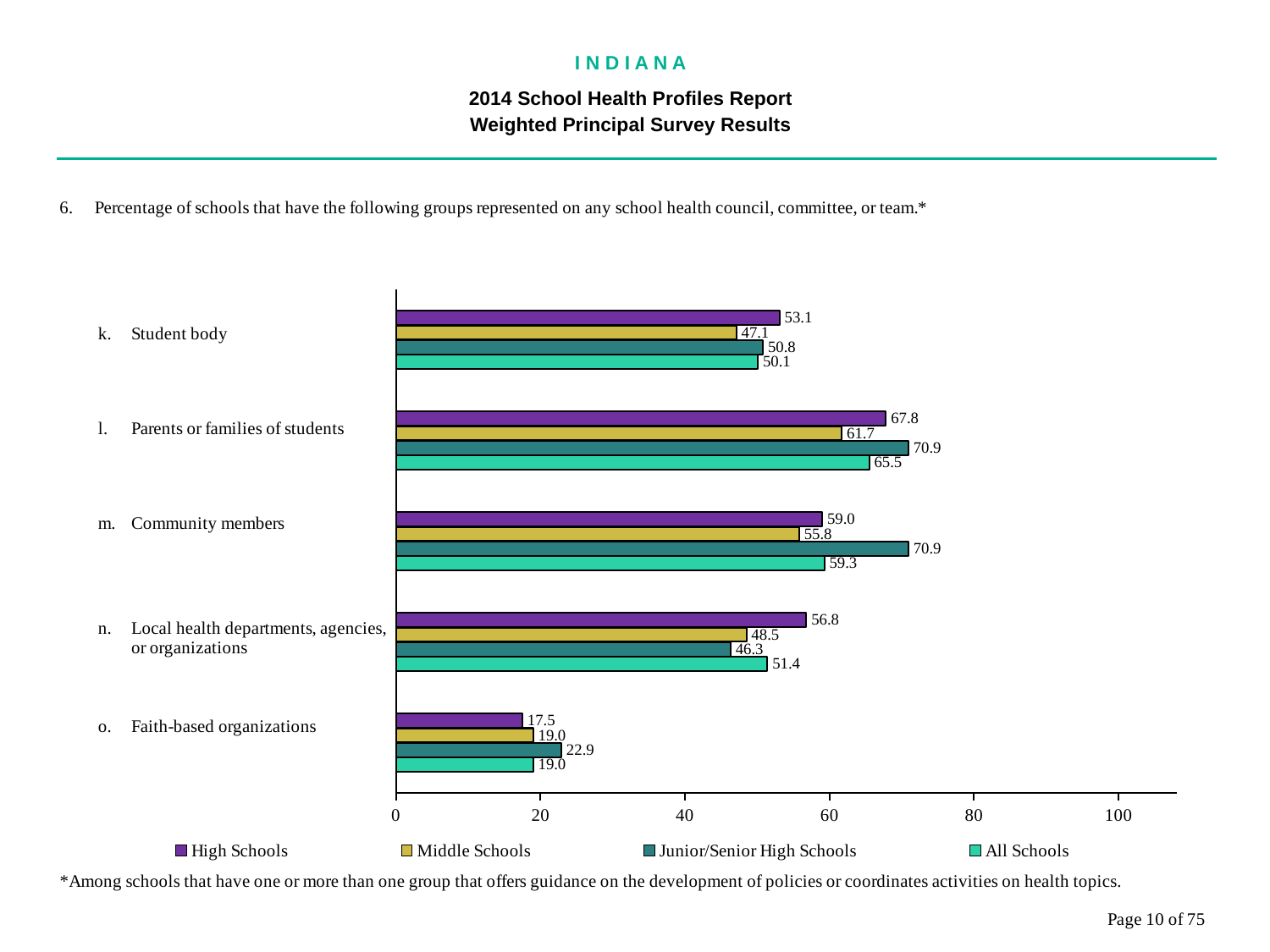
What is the value for High Schools for Student body? 53.1 How many series does the legend list? 4 What is the value for All Schools for Faith-based organizations? 19.0 What kind of chart is shown on the slide? Bar chart Which category has the highest value for Middle Schools? Parents or families of students What is the value for Junior/Senior High Schools for Community members? 70.9 Which series is shown in purple in the legend? High Schools Which category has the lowest value for High Schools? Faith-based organizations What is the difference between the High Schools and Middle Schools values for Parents or families of students? 6.1 How many categories are shown on the chart? 5 For Local health departments, agencies, or organizations, which is larger: the High Schools value or the Junior/Senior High Schools value? High Schools What is the value for Middle Schools for Local health departments, agencies, or organizations? 48.5